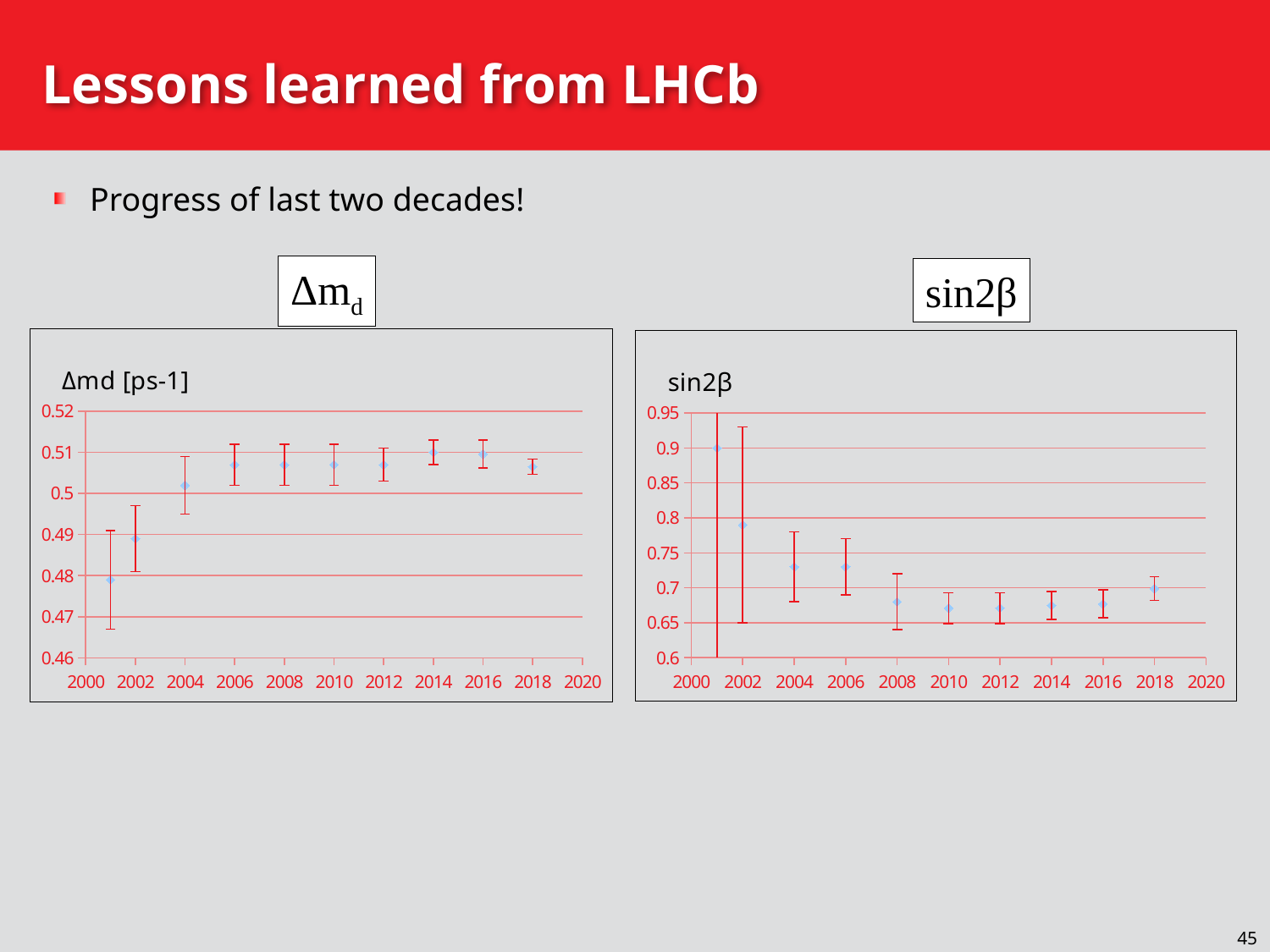
In the sin2β chart on the right, do the values generally rise or fall from 2001 to 2018? fall What is the title shown inside the chart on the right? sin2β In the Δmd [ps-1] chart on the left, is the value for 2001 greater or less than 0.49? less In the Δmd [ps-1] chart on the left, which is larger, the value for 2002 or the value for 2006? 2006 What kind of chart is the Δmd [ps-1] chart on the left? scatter chart with error bars In the Δmd [ps-1] chart on the left, is the value for 2006 greater or less than 0.5? greater In the Δmd [ps-1] chart on the left, which year has the lowest value? 2001 How many data points are plotted in the sin2β chart on the right? 10 In the sin2β chart on the right, is the value for 2001 greater or less than 0.85? greater How many data points are plotted in the Δmd [ps-1] chart on the left? 10 In the sin2β chart on the right, which year has the highest value? 2001